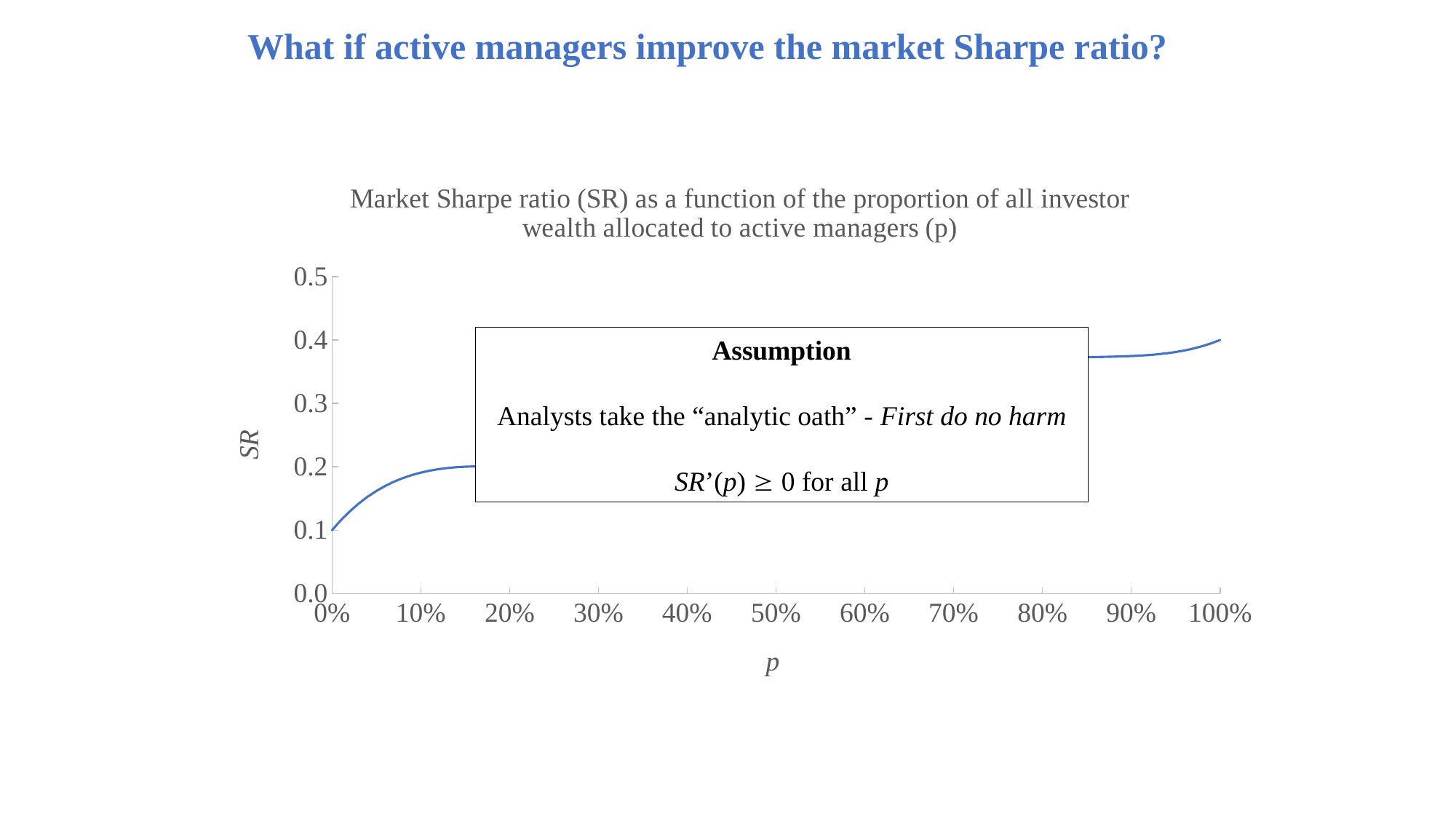
Does the SR line rise or fall as p increases from 0% to 100%? rises Is the value of SR at p = 90% greater or less than 0.3? greater Is the value of SR at p = 10% greater or less than 0.2? less At which value of p is SR lowest? 0% What is the value of SR at p = 100%? 0.4 What is the label of the vertical axis? SR What is the value of SR at p = 0%? 0.1 At which value of p is SR highest? 100% Which is larger, SR at p = 10% or SR at p = 90%? SR at p = 90% What is the title of the chart? Market Sharpe ratio (SR) as a function of the proportion of all investor wealth allocated to active managers (p) What is the difference between SR at p = 100% and SR at p = 0%? 0.3 What kind of chart is shown on the slide? line chart